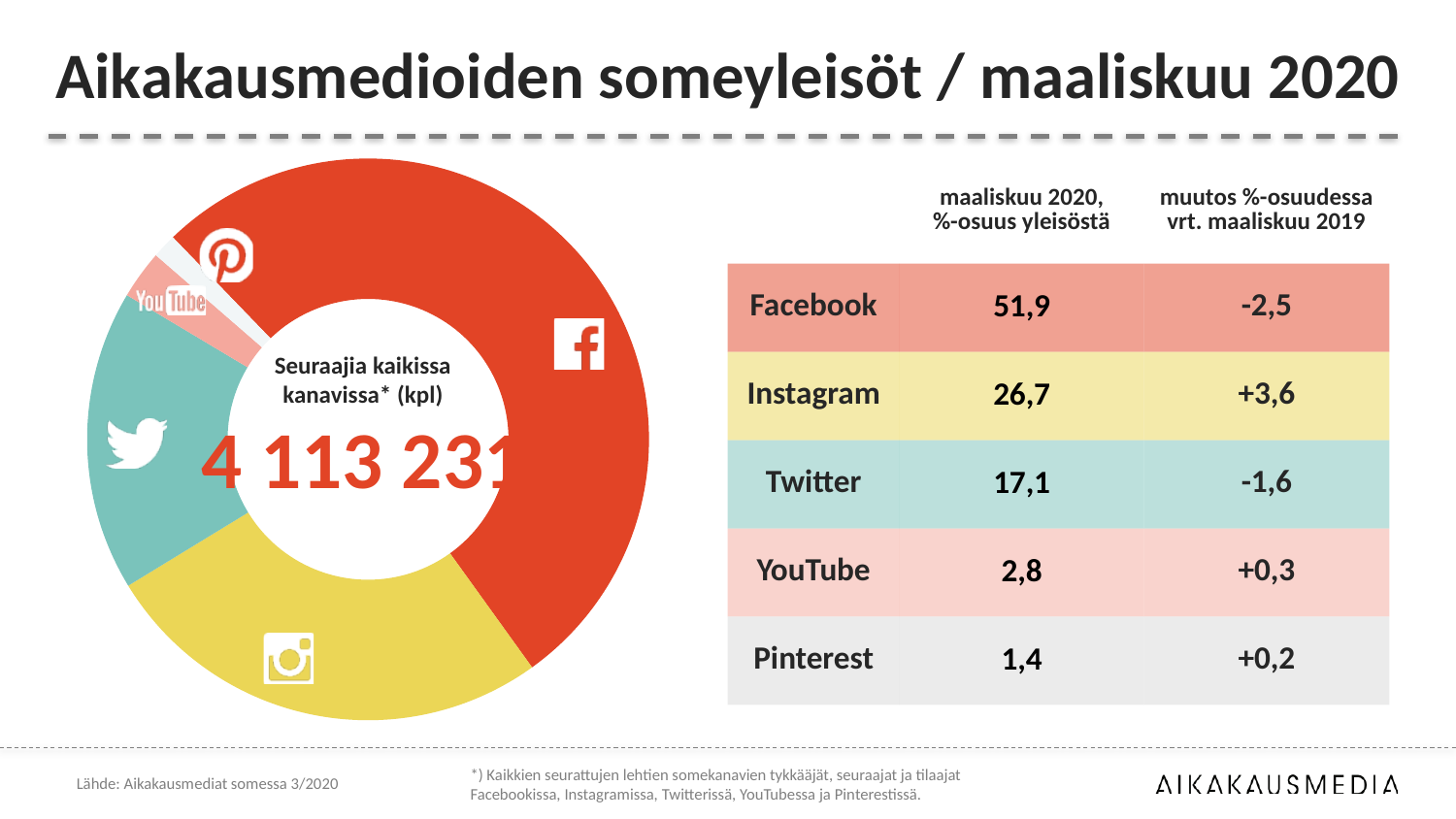
Which channel has a larger share of the audience in March 2020, Twitter or YouTube? Twitter How many social media channels are shown as slices in the donut chart? 5 What is the difference between Facebook's and Instagram's share of the audience in March 2020? 25,2 According to the table, what is Instagram's share of the audience in March 2020? 26,7 What total number of followers across all channels is printed in the centre of the donut chart? 4 113 231 According to the table, what is Facebook's share of the audience in March 2020 (%-osuus yleisöstä)? 51,9 According to the table, what is the change in Twitter's share compared with March 2019? -1,6 What colour is the Facebook slice in the donut chart? Red Which channel has the smallest share of the audience in March 2020? Pinterest Which channel has the largest slice of the donut chart? Facebook What kind of chart is shown on the left of the slide? Pie chart (donut) Which channel shows the largest increase in share compared with March 2019? Instagram